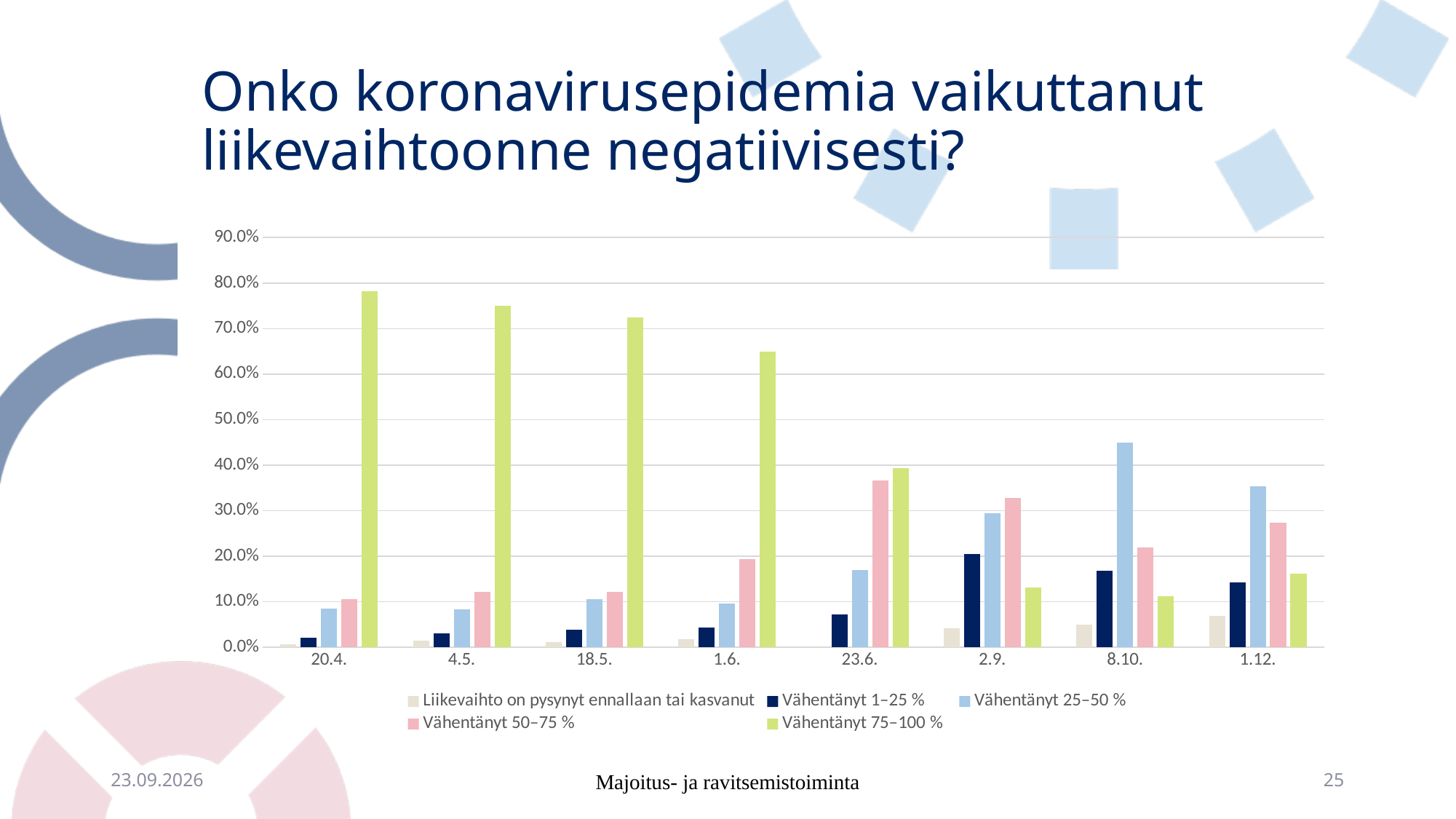
Is the value for Vähentänyt 25–50 % at 8.10. greater or less than 40.0%? greater How many series does the legend list? 5 Which series has the highest value at 8.10.? Vähentänyt 25–50 % At 1.12., which is larger: Vähentänyt 25–50 % or Vähentänyt 50–75 %? Vähentänyt 25–50 % How many date categories are shown on the x axis? 8 What kind of chart is shown on the slide? bar chart Is the value for Vähentänyt 75–100 % at 20.4. greater or less than 70.0%? greater At which date is the value for Vähentänyt 75–100 % highest? 20.4. Does the value for Vähentänyt 75–100 % rise or fall from 20.4. to 1.12.? fall At 2.9., which is larger: Vähentänyt 50–75 % or Vähentänyt 75–100 %? Vähentänyt 50–75 % What colour represents the series Vähentänyt 75–100 % in the legend? green Is the value for Vähentänyt 1–25 % at 2.9. greater or less than 10.0%? greater